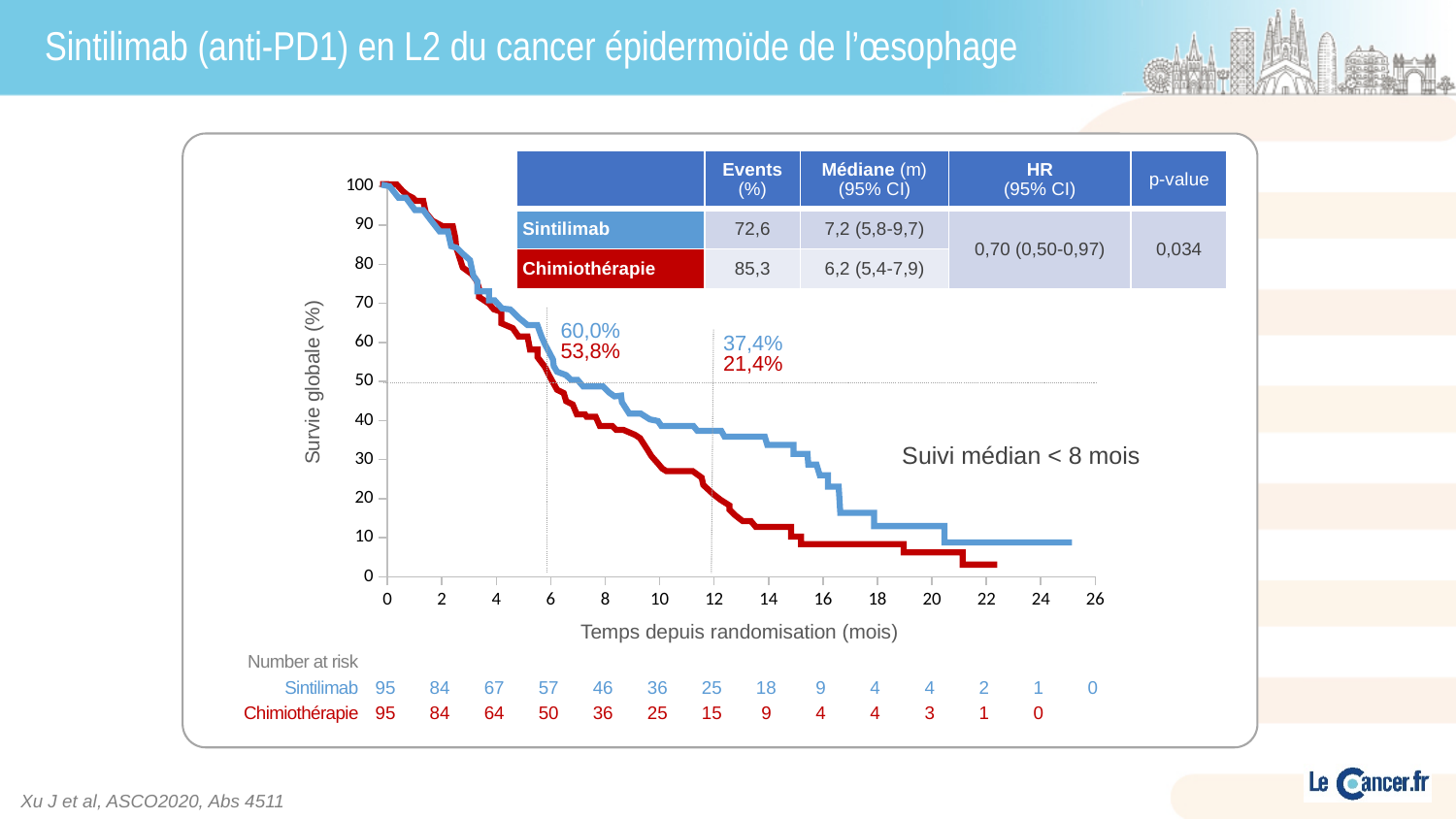
What is the median overall survival (in months) for Sintilimab according to the table? 7,2 (5,8-9,7) What is the p-value shown in the table? 0,034 How many patients were at risk in the Sintilimab arm at 8 months? 46 Which arm has the higher survival rate at 6 months, Sintilimab or Chimiothérapie? Sintilimab What is the hazard ratio (95% CI) shown in the table? 0,70 (0,50-0,97) What is the overall survival rate for Sintilimab at 6 months, as labelled on the chart? 60,0% What percentage of events is reported for Chimiothérapie in the table? 85,3 What is the overall survival rate for Chimiothérapie at 12 months, as labelled on the chart? 21,4% What is the label of the x axis? Temps depuis randomisation (mois) What kind of chart is shown on the slide? Kaplan-Meier survival curve (line chart) How many series (treatment arms) are plotted on the chart? 2 What is the difference between the Sintilimab and Chimiothérapie survival rates at 12 months? 16,0%